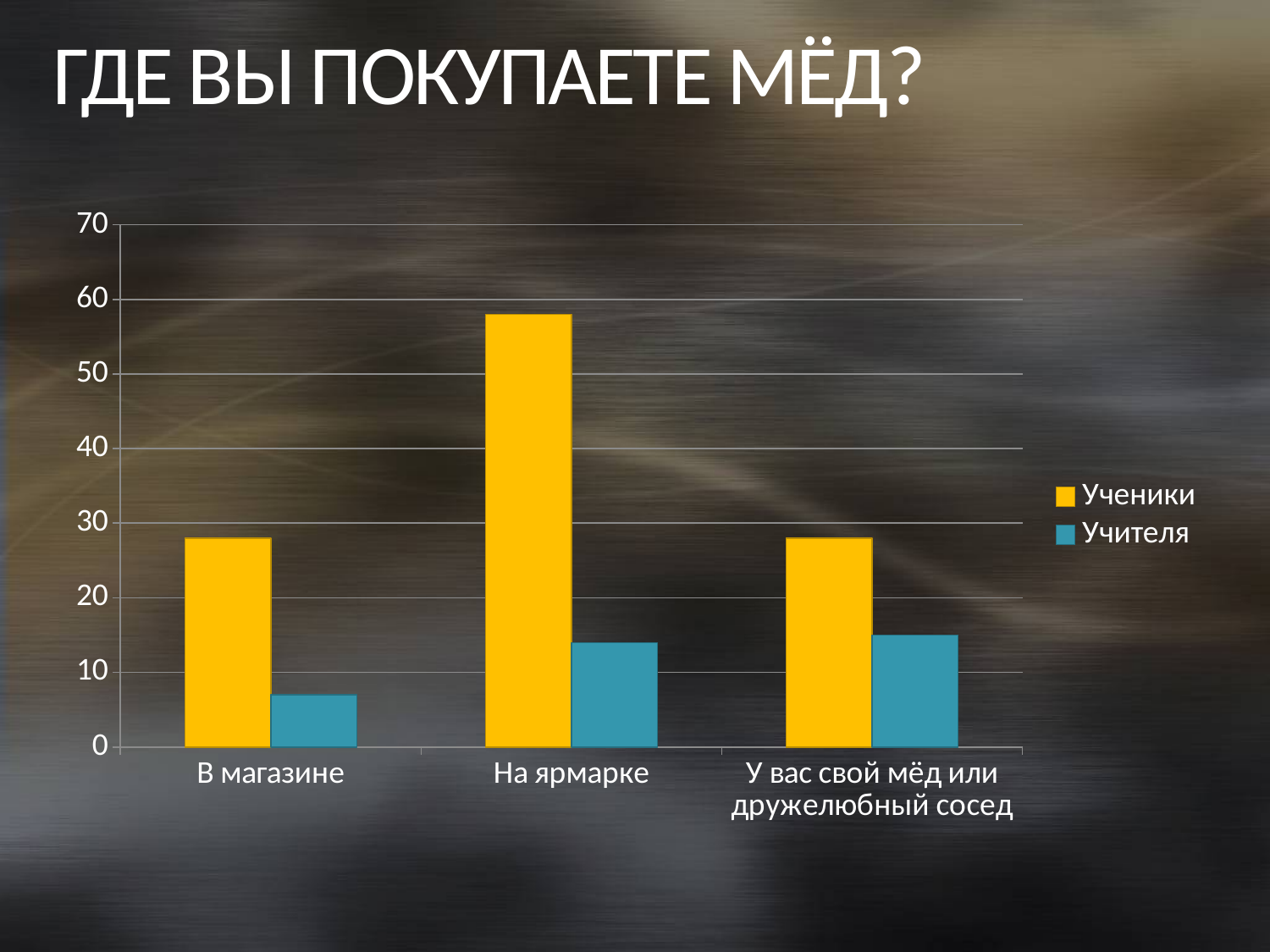
Is the value for Ученики in В магазине greater or less than 30? less How many series does the legend list? 2 Is the value for Ученики in На ярмарке greater or less than 50? greater Which category has the highest value for Ученики? На ярмарке Which colour represents the Учителя series in the legend? blue What is the title of the chart? ГДЕ ВЫ ПОКУПАЕТЕ МЁД? What kind of chart is shown on the slide? bar chart Is the value for Учителя in В магазине greater or less than 10? less In the category На ярмарке, which series has the larger value, Ученики or Учителя? Ученики How many categories are shown on the x axis? 3 Which category has the lowest value for Учителя? В магазине